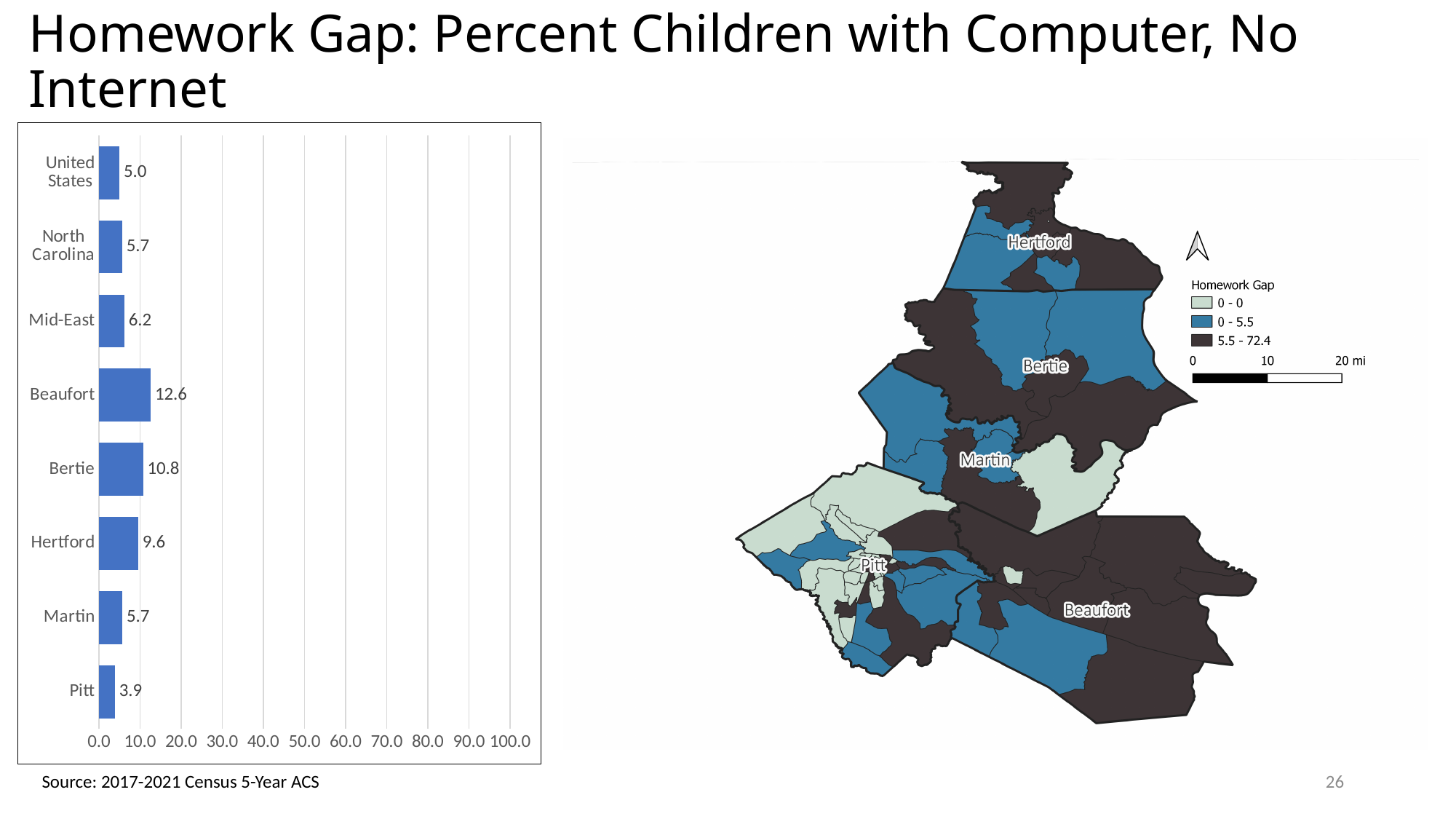
What is the value for Hertford in the bar chart? 9.6 How many categories are shown in the bar chart? 8 What is the value for Beaufort in the bar chart? 12.6 Which is larger in the bar chart, the value for Hertford or the value for Martin? Hertford Which category has the lowest value in the bar chart? Pitt What is the maximum value shown on the x axis of the bar chart? 100.0 What kind of chart is on the left of the slide? Bar chart What is the difference between the values for Beaufort and Bertie in the bar chart? 1.8 What is the difference between the values for North Carolina and the United States in the bar chart? 0.7 What is the value for Pitt in the bar chart? 3.9 What is the value for the United States in the bar chart? 5.0 Which category has the highest value in the bar chart? Beaufort